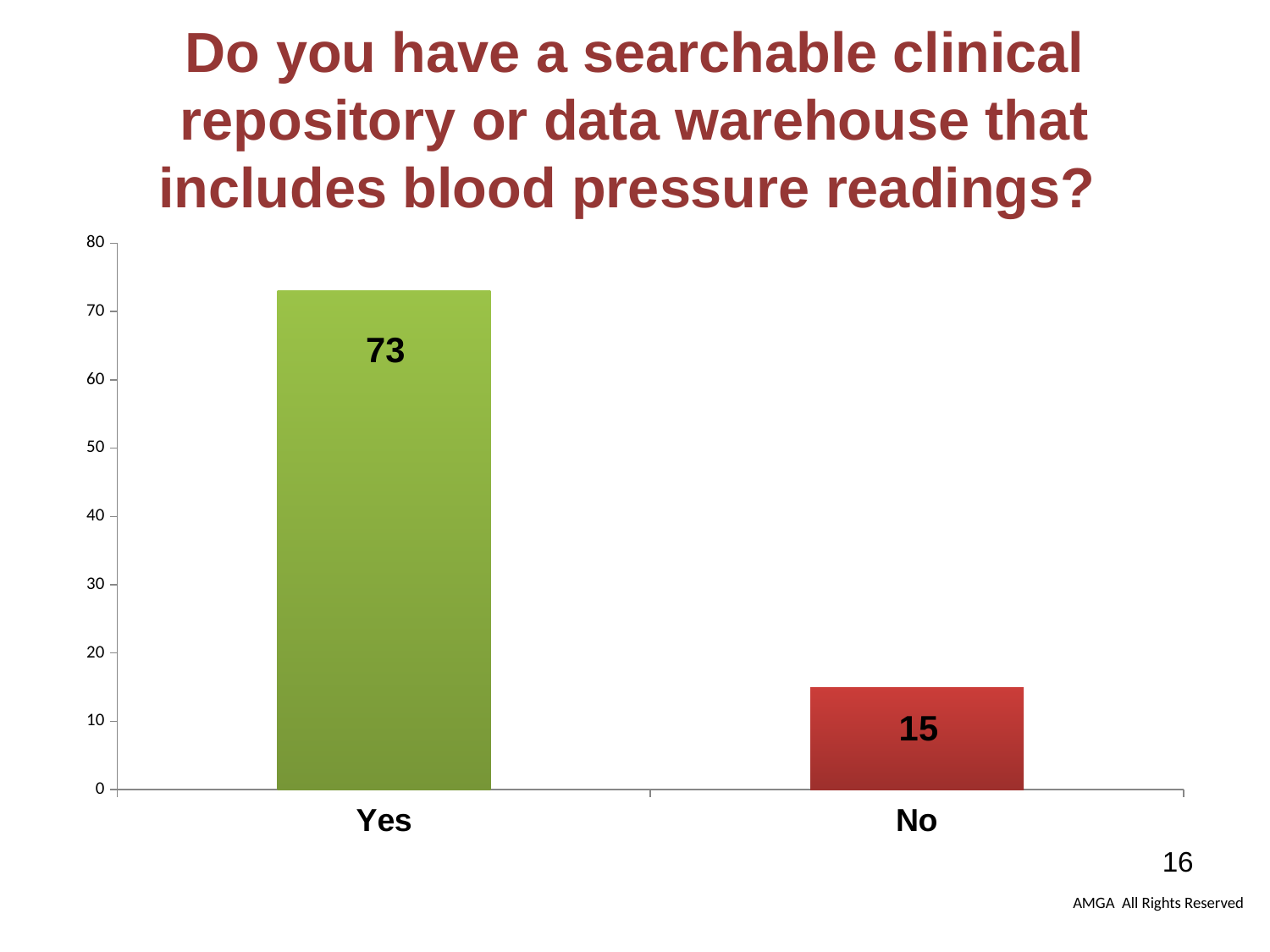
What is the value for No? 15 Is the value for No greater or less than 20? less What is the total of the values for Yes and No? 88 How many categories are shown on the x axis? 2 Which category has the highest value? Yes Which category has the lowest value? No What kind of chart is shown on the slide? bar chart Is the value for Yes greater or less than 70? greater What is the value for Yes? 73 What colour is the bar for No? red Which is larger, the value for Yes or the value for No? Yes What is the difference between the values for Yes and No? 58